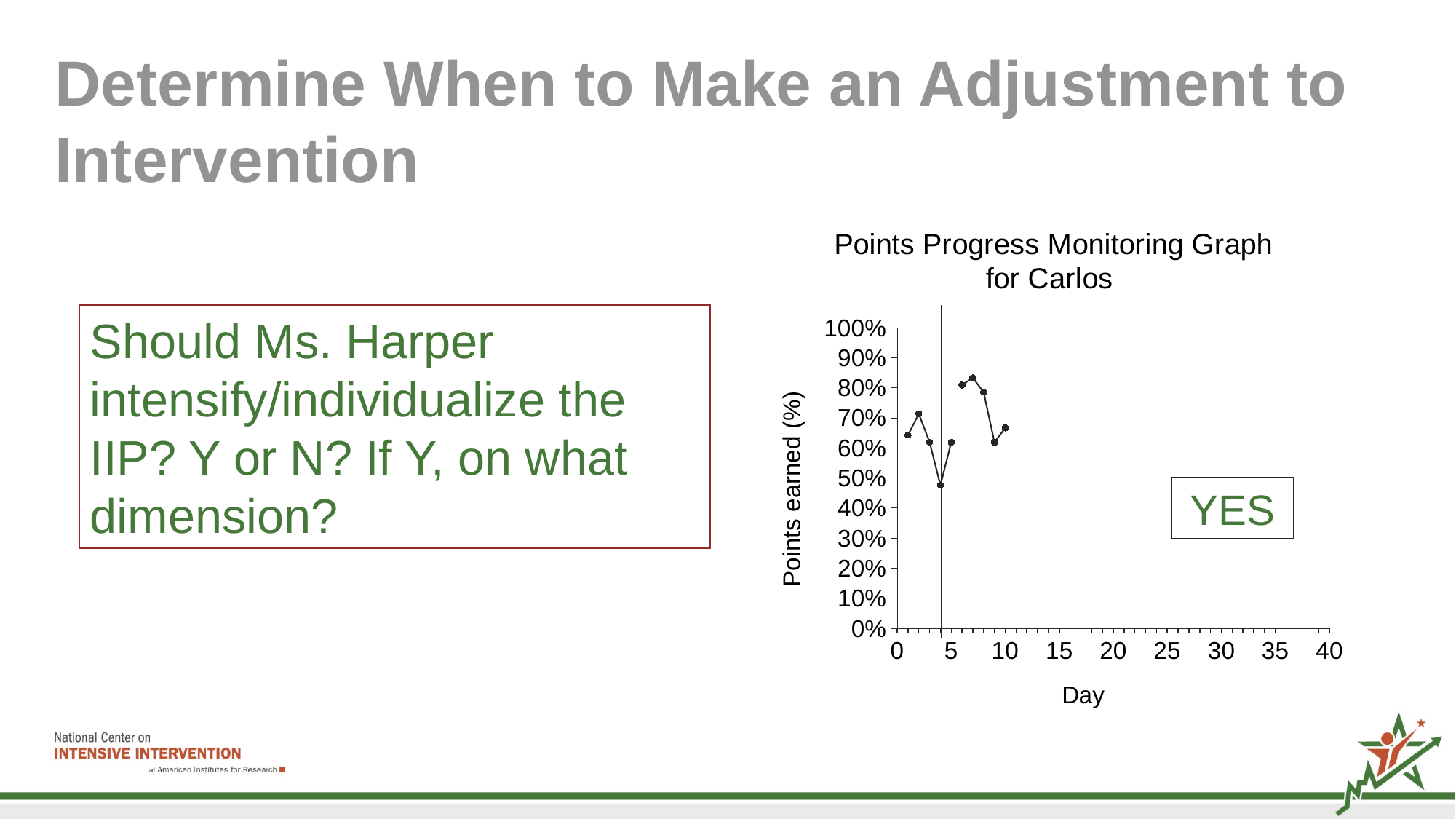
What is the label of the y axis on the chart? Points earned (%) How many data points are plotted on the chart? 10 What is the title of the chart on the slide? Points Progress Monitoring Graph for Carlos Is the value for day 9 greater or less than 70%? less Is the value for day 7 greater or less than 80%? greater On which day is the lowest value plotted on the chart? Day 4 Which is larger, the value for day 4 or the value for day 7? day 7 Do the plotted values rise or fall from day 7 to day 9? fall What kind of chart is the Points Progress Monitoring Graph for Carlos? line chart Is the value for day 4 greater or less than 50%? less Which is larger, the value for day 1 or the value for day 6? day 6